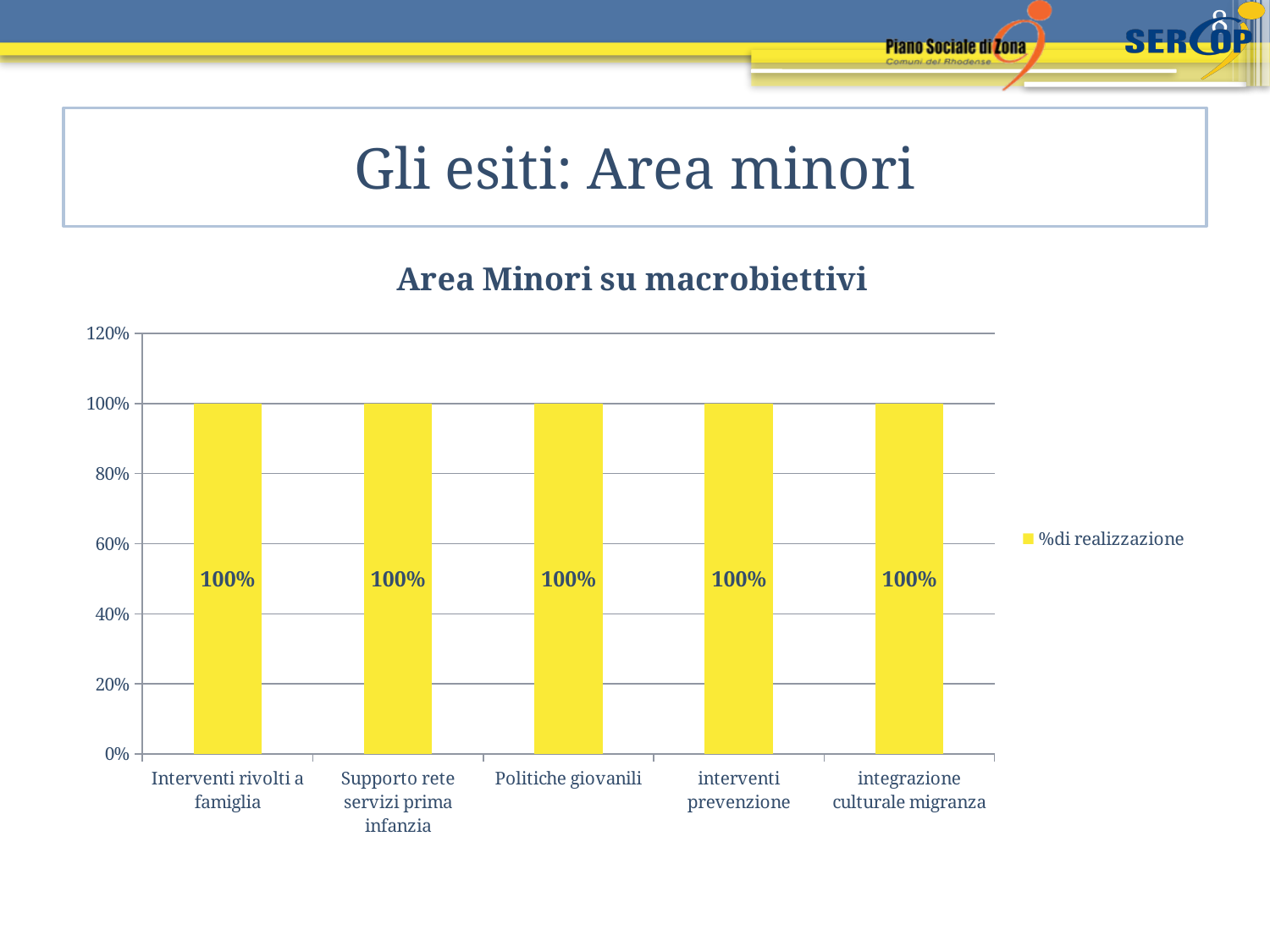
How many series does the legend list? 1 What is the difference between the values for interventi prevenzione and Politiche giovanili? 0% What is the title of the chart? Area Minori su macrobiettivi What is the value for Interventi rivolti a famiglia? 100% What is the name of the series in the legend? %di realizzazione Is the value for interventi prevenzione greater or less than 80%? greater What kind of chart is shown? bar chart How many categories are shown on the x axis? 5 What is the value for integrazione culturale migranza? 100% What is the value for Politiche giovanili? 100% What is the value for Supporto rete servizi prima infanzia? 100% Do the values rise, fall or stay the same across the categories? stay the same